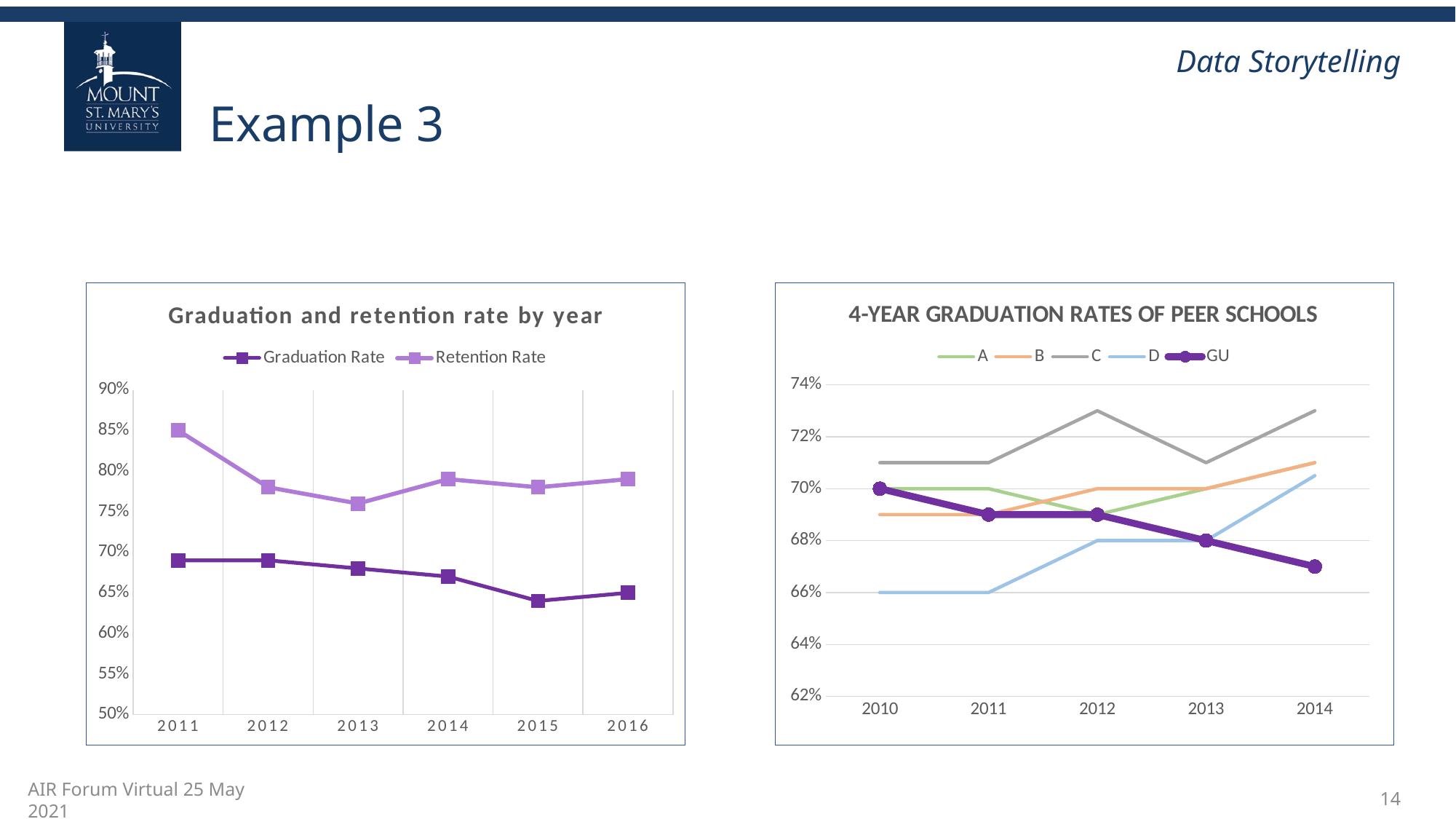
In the 'Graduation and retention rate by year' chart, what is the Retention Rate for 2011? 85% In the 'Graduation and retention rate by year' chart, which year has the higher Retention Rate, 2011 or 2016? 2011 How many years are shown on the x axis of the 'Graduation and retention rate by year' chart? 6 What kind of chart is the 'Graduation and retention rate by year' chart? Line chart In the '4-YEAR GRADUATION RATES OF PEER SCHOOLS' chart, which school has the lowest graduation rate in 2010? D In the '4-YEAR GRADUATION RATES OF PEER SCHOOLS' chart, what is the value for GU in 2010? 70% In the 'Graduation and retention rate by year' chart, does the Graduation Rate rise or fall between 2011 and 2015? Fall In the '4-YEAR GRADUATION RATES OF PEER SCHOOLS' chart, does the GU line rise or fall from 2010 to 2014? Fall In the '4-YEAR GRADUATION RATES OF PEER SCHOOLS' chart, what is the value for GU in 2013? 68% How many series does the legend of the '4-YEAR GRADUATION RATES OF PEER SCHOOLS' chart list? 5 In the 'Graduation and retention rate by year' chart, is the Graduation Rate for 2015 greater or less than 65%? Less How many series does the legend of the 'Graduation and retention rate by year' chart list? 2